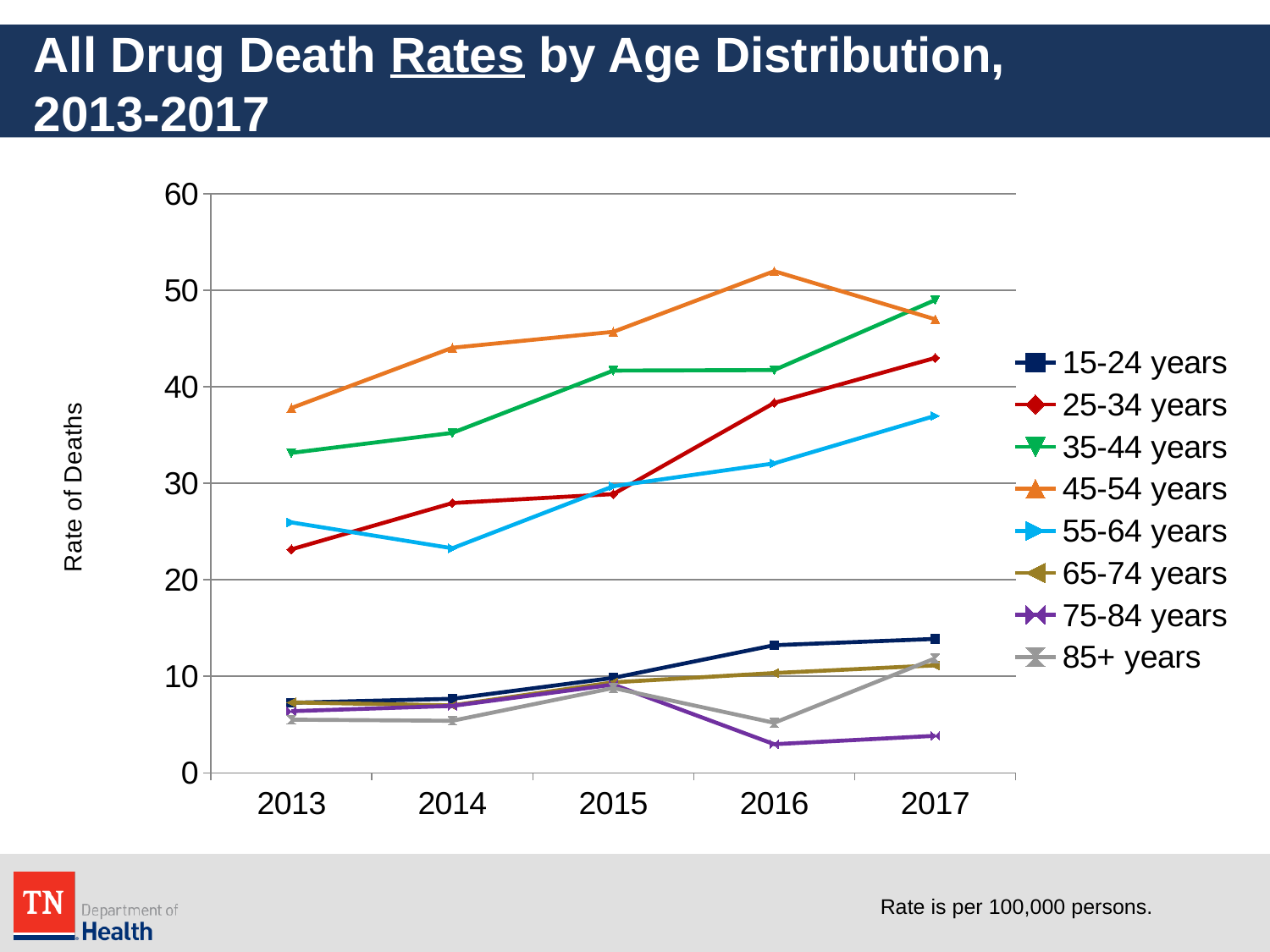
How many years are shown along the x axis? 5 Is the value for 45-54 years in 2016 greater or less than 50? greater Is the value for 85+ years in 2016 greater or less than 10? less Which age group has the highest rate of deaths in 2016? 45-54 years Which age group has the lowest rate of deaths in 2016? 75-84 years What kind of chart is shown on the slide? Line chart Is the value for 25-34 years in 2013 greater or less than 30? less How many age groups does the legend list? 8 What is the label on the y axis? Rate of Deaths In 2013, which has the higher rate of deaths: 55-64 years or 25-34 years? 55-64 years Which age group has the highest rate of deaths in 2013? 45-54 years Does the rate of deaths for 15-24 years rise or fall from 2013 to 2017? Rise